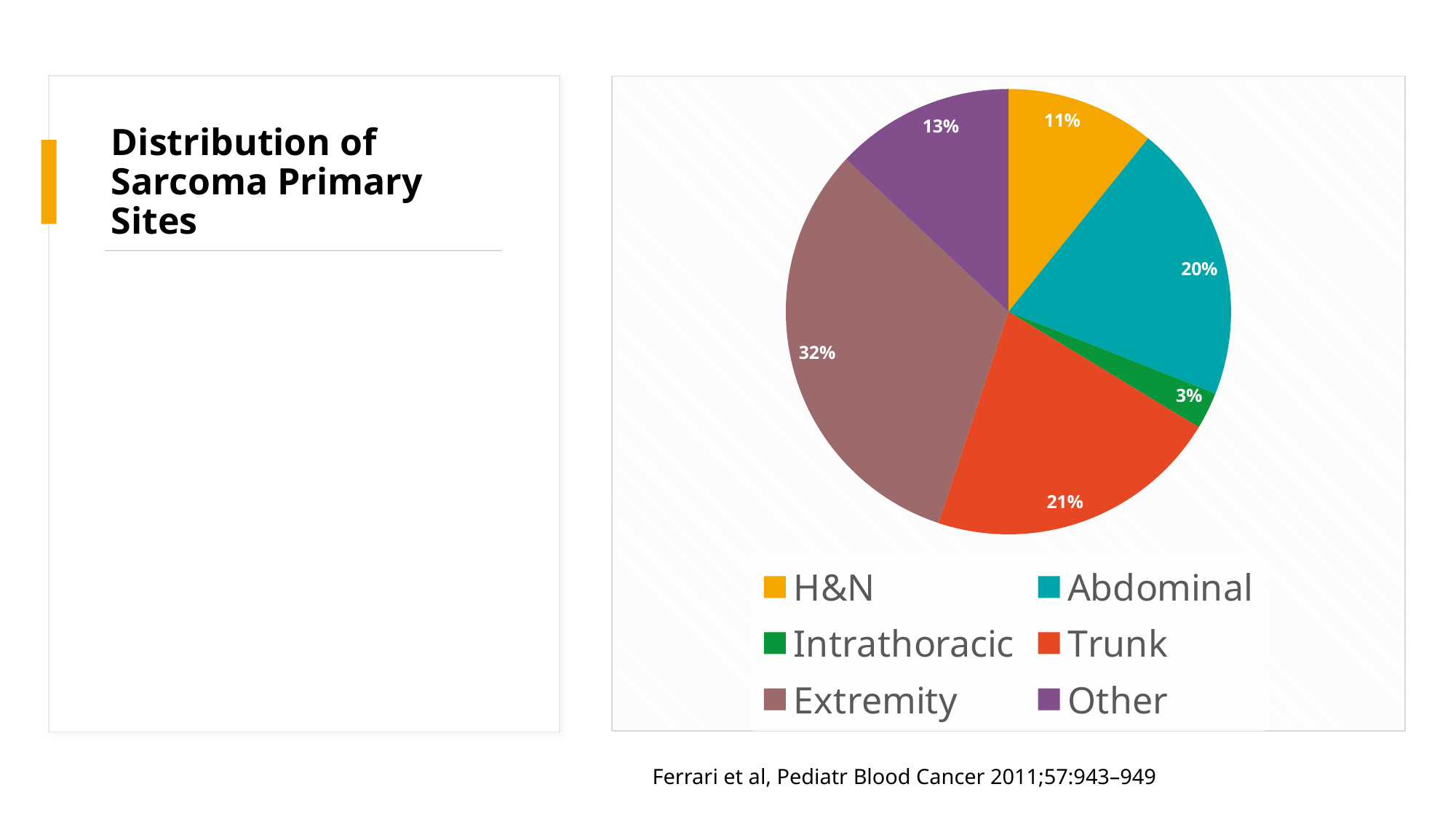
What percentage of sarcoma primary sites is Abdominal? 20% How many primary site categories are shown in the pie chart? 6 What kind of chart is shown on the slide? pie chart What is the title of the slide containing the pie chart? Distribution of Sarcoma Primary Sites Which primary site has the smallest share of the pie? Intrathoracic What colour represents Trunk in the pie chart? red What percentage of sarcoma primary sites is Intrathoracic? 3% What percentage of sarcoma primary sites is Extremity? 32% Which primary site has the largest share of the pie? Extremity What percentage of sarcoma primary sites is H&N? 11% Which has a larger share, Other or H&N? Other What is the difference in percentage points between Extremity and Trunk? 11